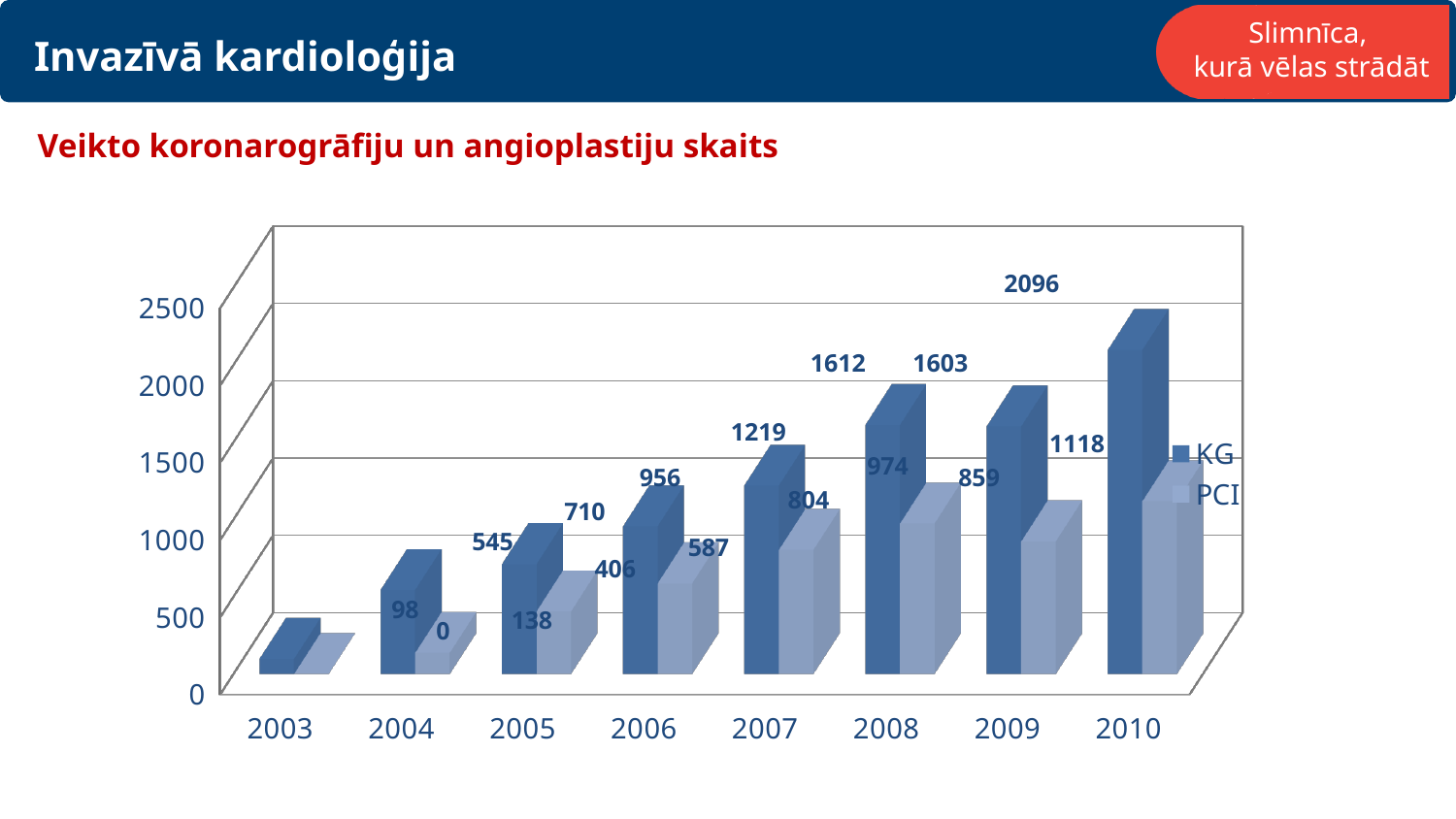
In which year is the KG value highest? 2010 What is the title of the chart? Veikto koronarogrāfiju un angioplastiju skaits Which is larger in 2008, the KG value or the PCI value? KG How many years are shown on the x axis? 8 In which year is the PCI value lowest? 2003 What is the KG value for 2010? 2096 Does the KG value generally rise or fall from 2003 to 2010? rise What kind of chart is shown on the slide? bar chart What is the difference between the KG and PCI values in 2010? 978 How many series does the legend list? 2 What is the KG value for 2007? 1219 What is the PCI value for 2010? 1118